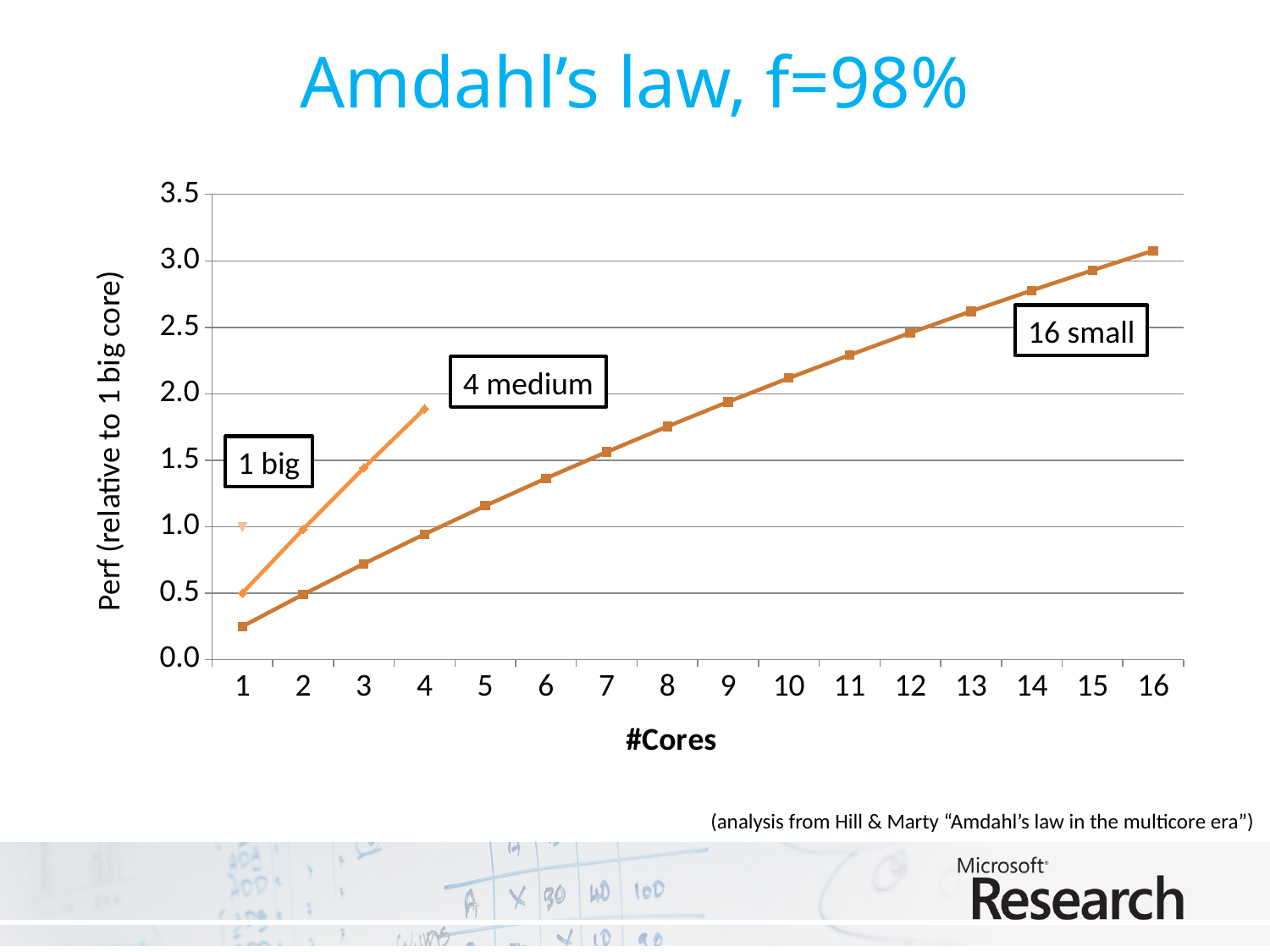
What is the label of the x axis? #Cores Is the value of the "16 small" series at 1 core greater or less than 0.5? less At 4 cores, which series has the larger value, "4 medium" or "16 small"? 4 medium Is the value of the "16 small" series at 16 cores greater or less than 2.5? greater Which series reaches the highest performance value on the chart? 16 small What kind of chart is shown on the slide? line chart What is the title of the chart? Amdahl's law, f=98% How many data points does the "16 small" series have? 16 What is the value of the "1 big" series at 1 core? 1.0 How many series are labelled on the chart? 3 Does the "16 small" series rise or fall as the number of cores increases? rises Is the value of the "4 medium" series at 4 cores greater or less than 2.0? less